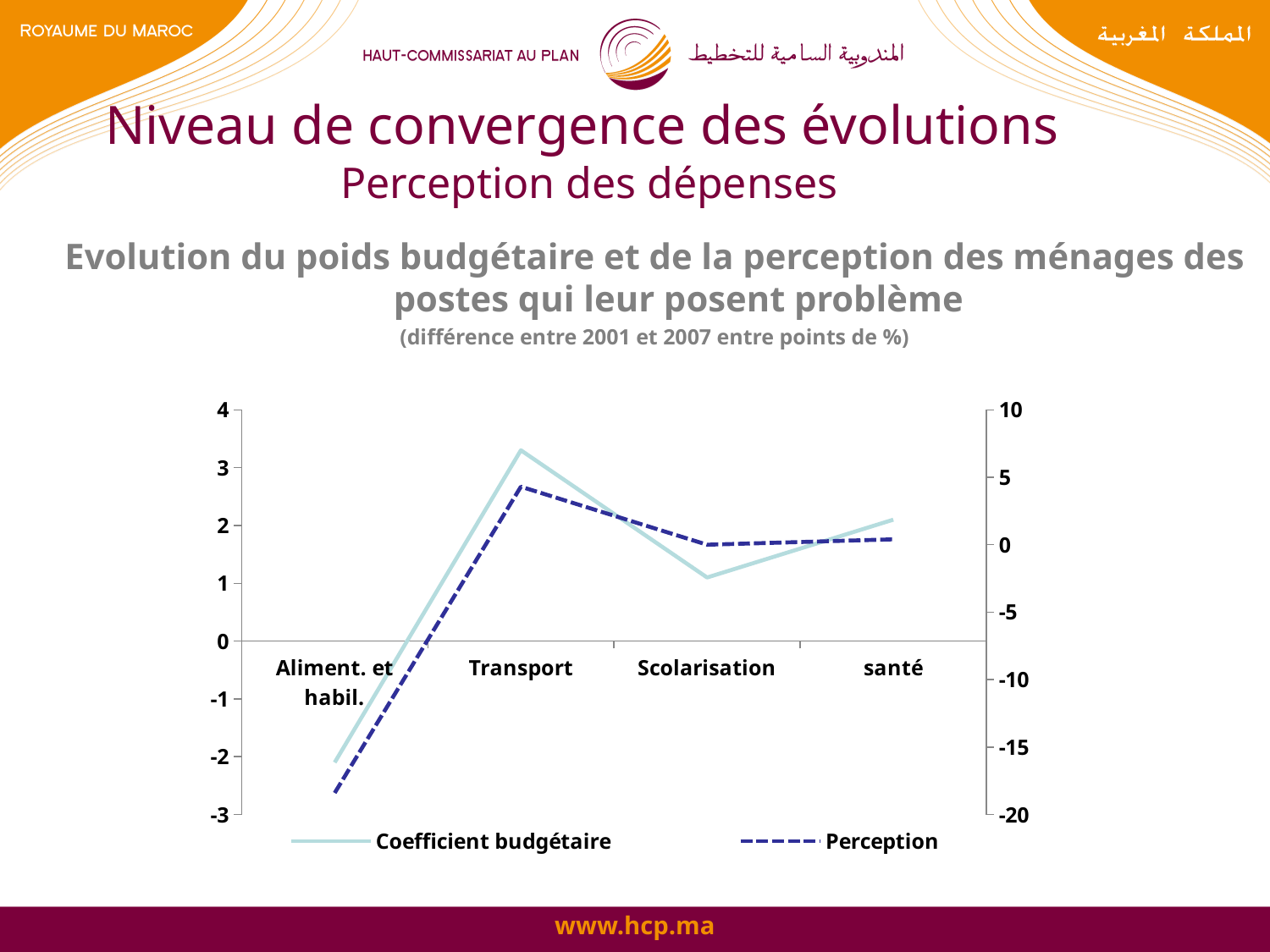
Is the Coefficient budgétaire value for Aliment. et habil. greater or less than -1? less Does the Coefficient budgétaire line rise or fall from Transport to Scolarisation? fall How many categories are plotted along the x axis? 4 For the Coefficient budgétaire series, which is larger: Scolarisation or santé? santé What kind of chart is shown on the slide? Line chart Is the Perception value for Aliment. et habil. greater or less than -10 on the right axis? less Which category has the highest value for the Coefficient budgétaire series? Transport Which series is drawn with a dashed line? Perception Is the Coefficient budgétaire value for Scolarisation greater or less than 2? less Which category has the lowest value for the Perception series? Aliment. et habil. How many series does the legend list? 2